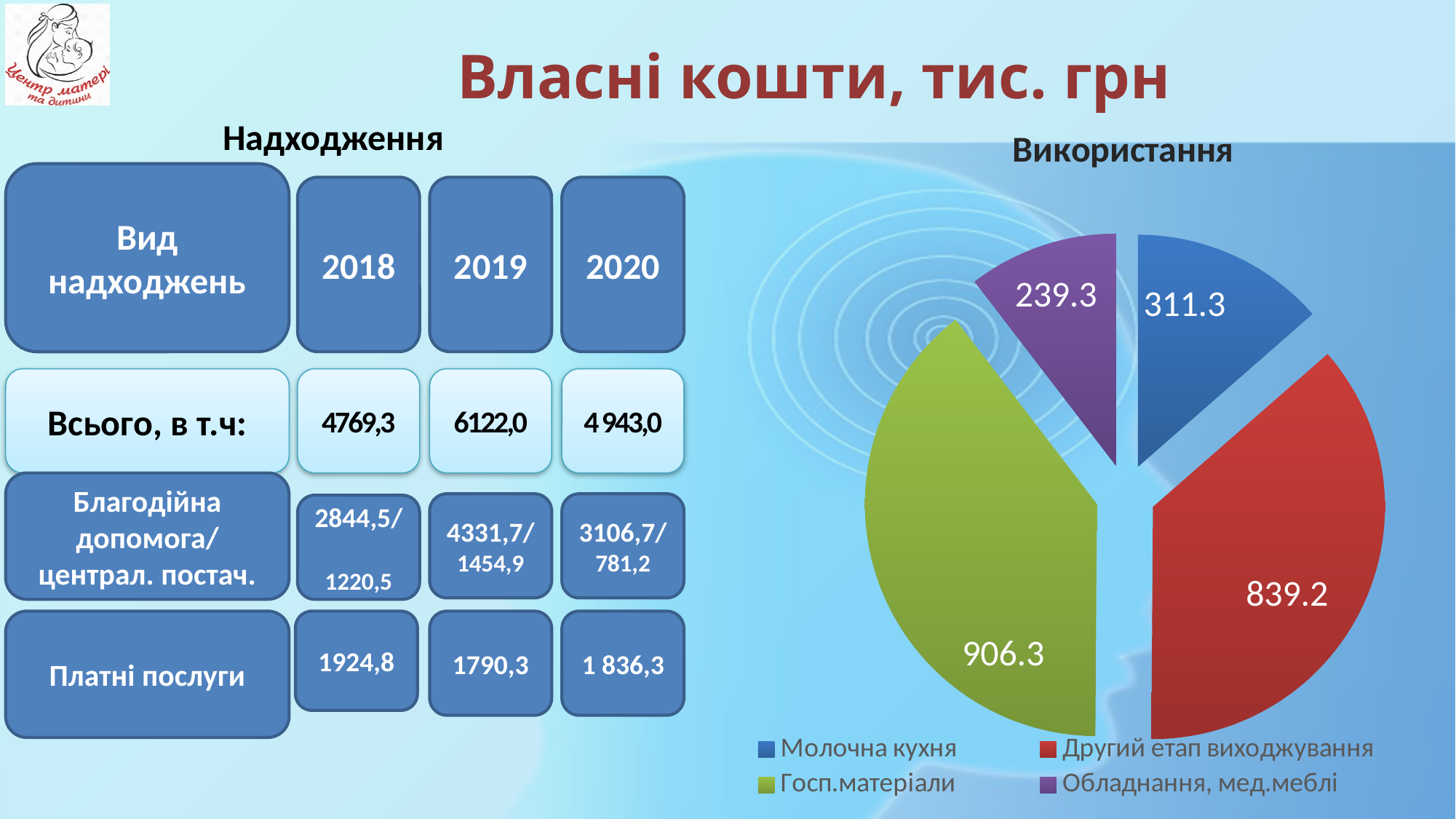
What kind of chart is shown under the heading "Використання"? pie chart In the "Використання" pie chart, which is larger: Молочна кухня or Другий етап виходжування? Другий етап виходжування In the "Використання" pie chart, what is the value for Обладнання, мед.меблі? 239.3 In the "Використання" pie chart, what is the difference between Госп.матеріали and Другий етап виходжування? 67.1 In the "Використання" pie chart, what is the value for Молочна кухня? 311.3 In the "Використання" pie chart, what colour is the slice for Госп.матеріали? green In the "Використання" pie chart, what is the difference between Молочна кухня and Обладнання, мед.меблі? 72.0 In the "Використання" pie chart, what is the value for Другий етап виходжування? 839.2 In the "Використання" pie chart, which category has the smallest value? Обладнання, мед.меблі In the "Використання" pie chart, what is the value for Госп.матеріали? 906.3 How many slices does the "Використання" pie chart have? 4 In the "Використання" pie chart, which category has the largest value? Госп.матеріали